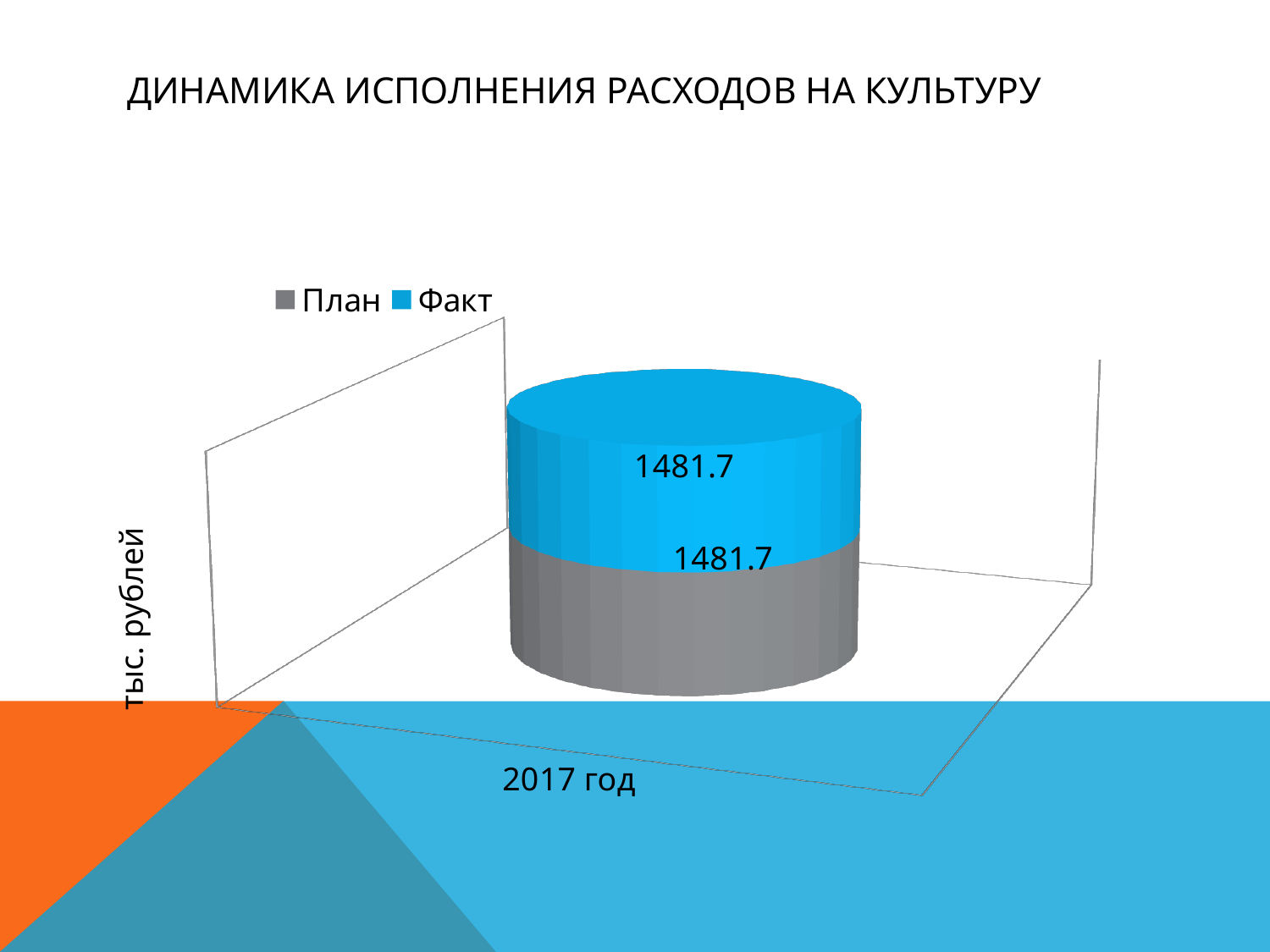
What is the title of the chart on the slide? ДИНАМИКА ИСПОЛНЕНИЯ РАСХОДОВ НА КУЛЬТУРУ How many series does the legend list? 2 What is the difference between the Факт and План values for 2017 год? 0 What is the value for План (plan) in 2017 год? 1481.7 How many categories are shown on the x axis of the chart? 1 What is the total of the stacked bar for 2017 год? 2963.4 Is the Факт value for 2017 год larger than, smaller than, or equal to the План value? equal What kind of chart is shown on the slide? stacked bar chart What unit is shown on the vertical axis label of the chart? тыс. рублей What is the value for Факт (actual) in 2017 год? 1481.7